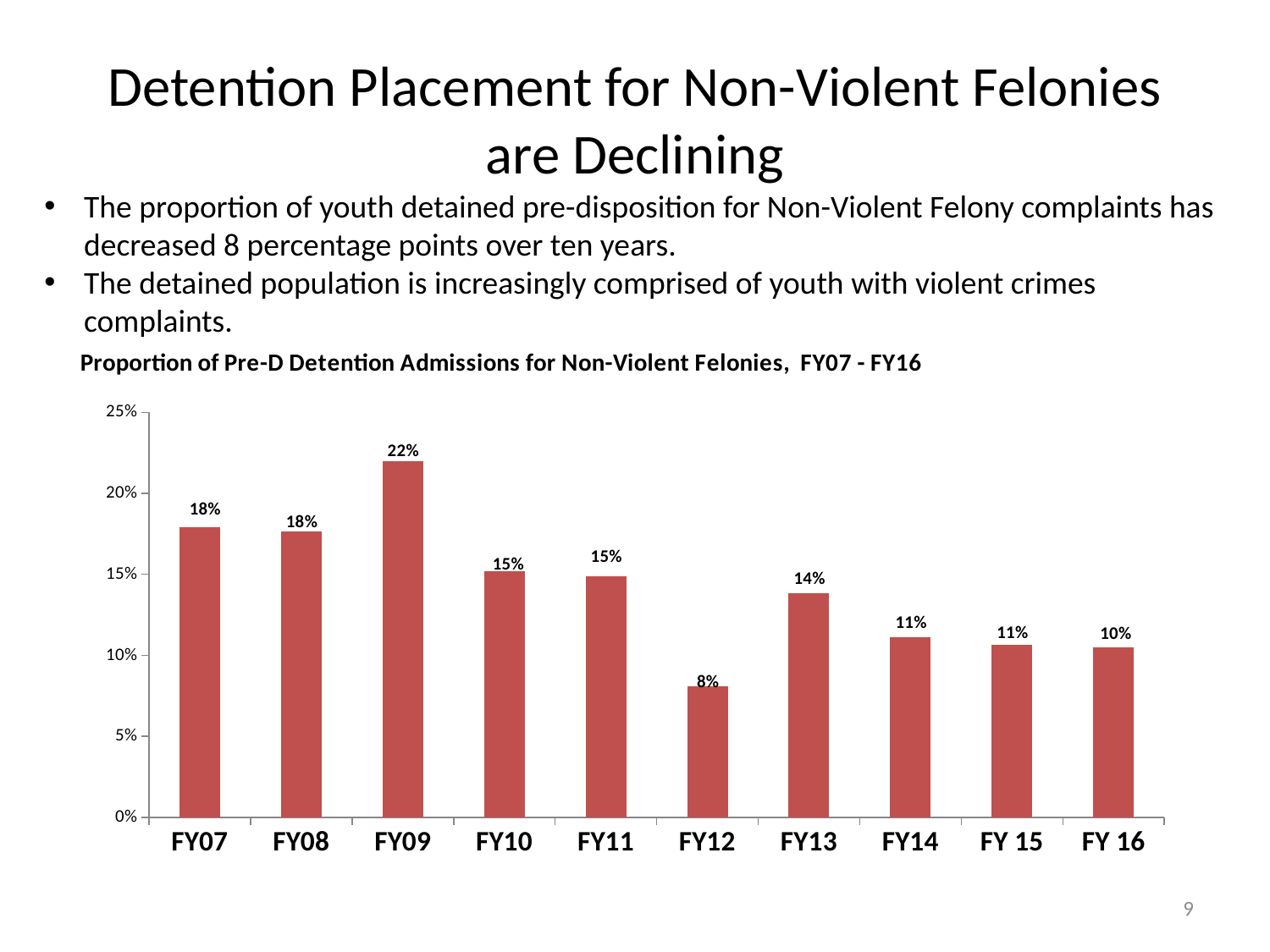
How many fiscal years are shown on the x axis? 10 What is the value for FY13? 14% What is the value for FY12? 8% Is the value for FY11 greater or less than 10%? greater What is the title of the chart? Proportion of Pre-D Detention Admissions for Non-Violent Felonies, FY07 - FY16 Which is larger, the value for FY07 or the value for FY14? FY07 What is the value for FY09? 22% What is the difference between the values for FY09 and FY12? 14% Which fiscal year has the highest value? FY09 Which fiscal year has the lowest value? FY12 What kind of chart is shown on the slide? Bar chart What is the value for FY 16? 10%